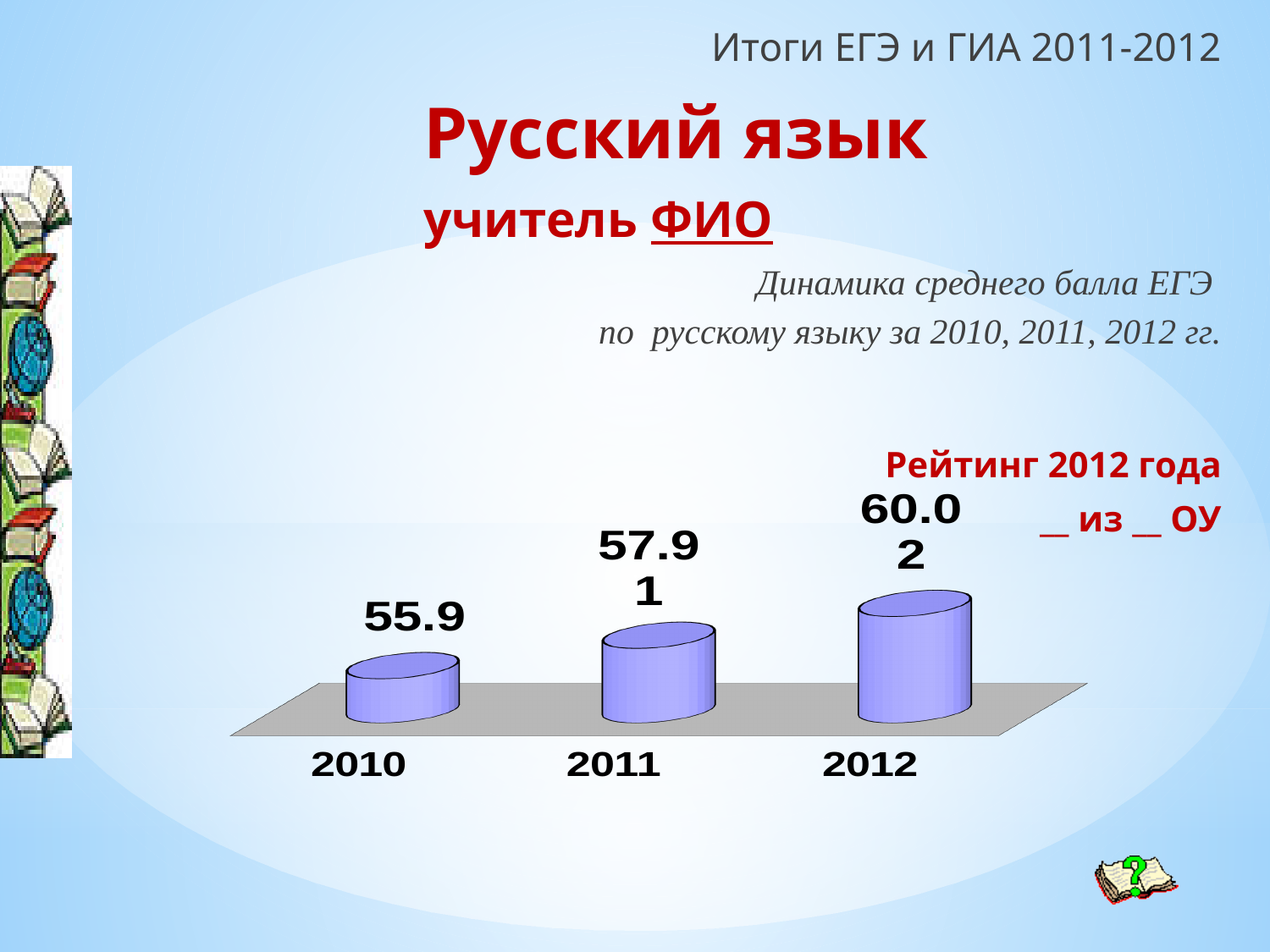
What is the value shown for 2012? 60.02 What subject does the chart on the slide refer to? Русский язык Which is larger, the value for 2011 or the value for 2012? 2012 How many years are plotted on the chart? 3 What is the average EGE score shown for 2010? 55.9 What kind of chart is shown on the slide? Bar chart What is the difference between the values for 2012 and 2010? 4.12 Do the values rise or fall from 2010 to 2012? Rise What is the value shown for 2011? 57.91 What is the difference between the values for 2011 and 2010? 2.01 Which year has the highest value on the chart? 2012 Which year has the lowest value on the chart? 2010